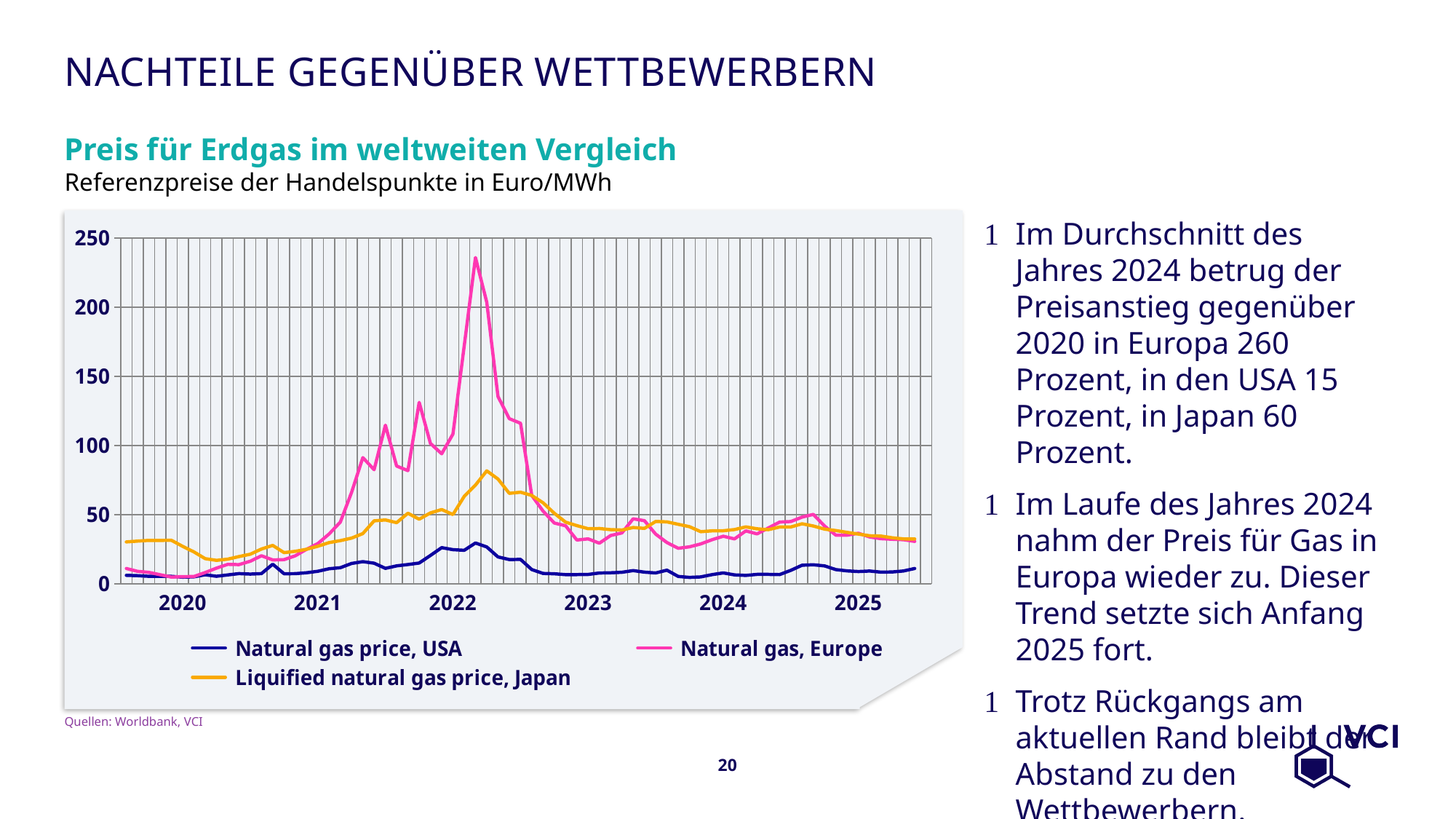
What is the highest value shown on the y axis of the chart? 250 What is the title of the chart? Preis für Erdgas im weltweiten Vergleich Is the peak value of the Natural gas, Europe series greater or less than 200? greater Is the peak value of the Natural gas price, USA series greater or less than 50? less At the start of 2020, which is larger: the Liquified natural gas price, Japan or the Natural gas, Europe price? Liquified natural gas price, Japan How many series does the legend of the chart list? 3 Which series is shown in pink in the chart? Natural gas, Europe What kind of chart is shown on the slide? line chart Does the Natural gas, Europe series rise or fall between its 2022 peak and the start of 2023? fall Which series reaches the highest value in the chart? Natural gas, Europe Is the peak value of the Liquified natural gas price, Japan series greater or less than 100? less